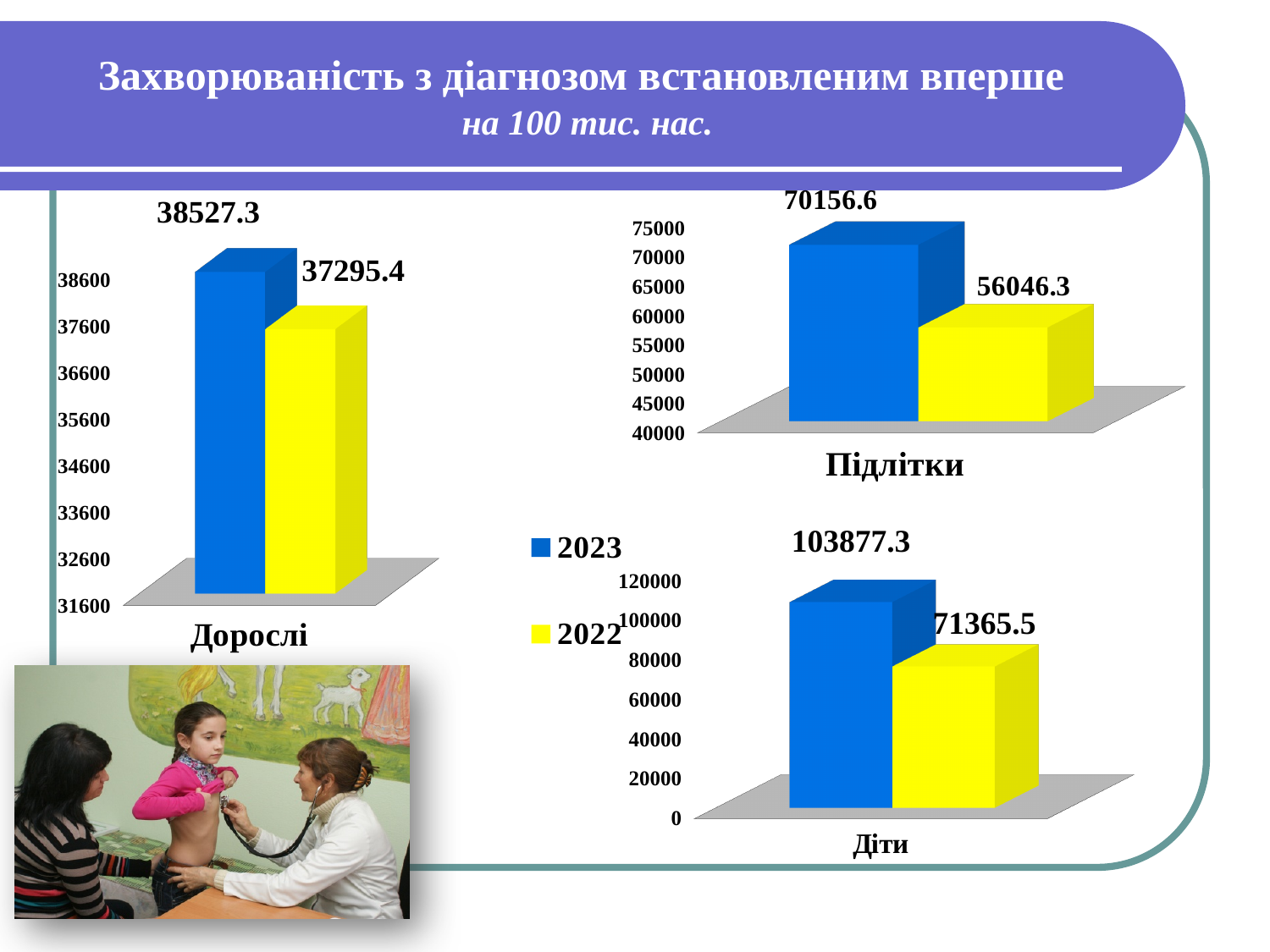
In the Діти chart, what is the difference between the 2023 and 2022 values? 32511.8 In the Підлітки chart, what is the value for 2023? 70156.6 In the Дорослі chart, what is the value for 2023? 38527.3 In the Підлітки chart, what is the value for 2022? 56046.3 What kind of chart is the Підлітки chart? bar chart In the Діти chart, what is the value for 2023? 103877.3 In the Діти chart, what is the value for 2022? 71365.5 In the Дорослі chart, which year has the larger value, 2023 or 2022? 2023 In the Підлітки chart, what is the difference between the 2023 and 2022 values? 14110.3 How many series does the legend list? 2 In the Діти chart, is the value for 2022 greater or less than 80000? less In the Дорослі chart, what is the value for 2022? 37295.4